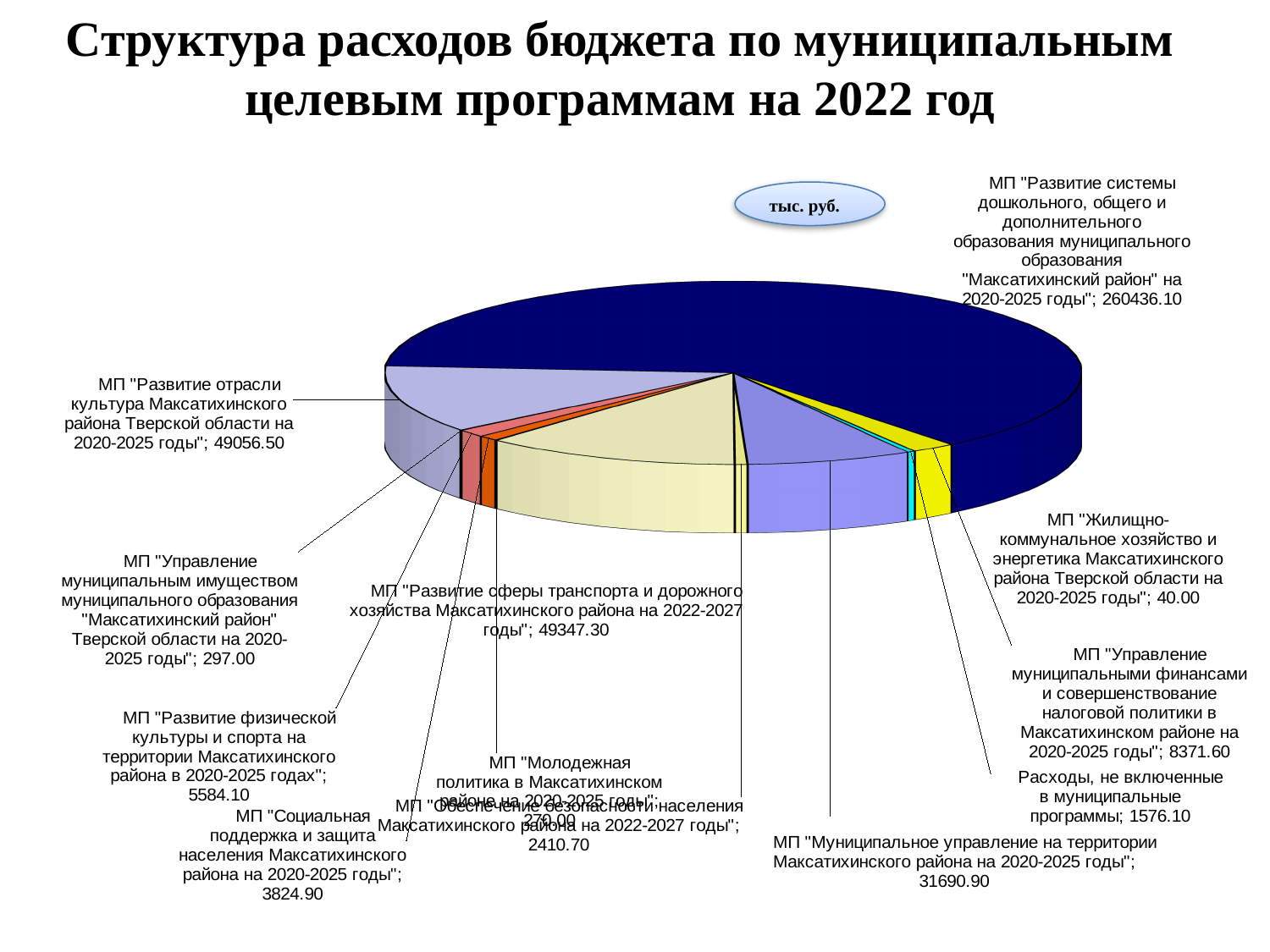
What is the value for МП "Управление муниципальными финансами и совершенствование налоговой политики в Максатихинском районе на 2020-2025 годы"? 8371.60 Which is larger: the value for МП "Развитие физической культуры и спорта" or МП "Социальная поддержка и защита населения"? МП "Развитие физической культуры и спорта" How many slices does the pie chart have? 12 What is the value for Расходы, не включенные в муниципальные программы? 1576.10 Which program has the largest slice of the pie? МП "Развитие системы дошкольного, общего и дополнительного образования муниципального образования "Максатихинский район" на 2020-2025 годы" In what units are the values on the chart given, according to the label on the slide? тыс. руб. What is the value for МП "Развитие сферы транспорта и дорожного хозяйства Максатихинского района на 2022-2027 годы"? 49347.30 What is the difference between the value for МП "Развитие сферы транспорта и дорожного хозяйства" (49347.30) and МП "Развитие отрасли культура" (49056.50)? 290.80 Which program has the smallest value on the chart? МП "Жилищно-коммунальное хозяйство и энергетика Максатихинского района Тверской области на 2020-2025 годы" What kind of chart is shown on the slide? Pie chart What is the value for МП "Развитие системы дошкольного, общего и дополнительного образования муниципального образования "Максатихинский район" на 2020-2025 годы"? 260436.10 What is the value for МП "Муниципальное управление на территории Максатихинского района на 2020-2025 годы"? 31690.90